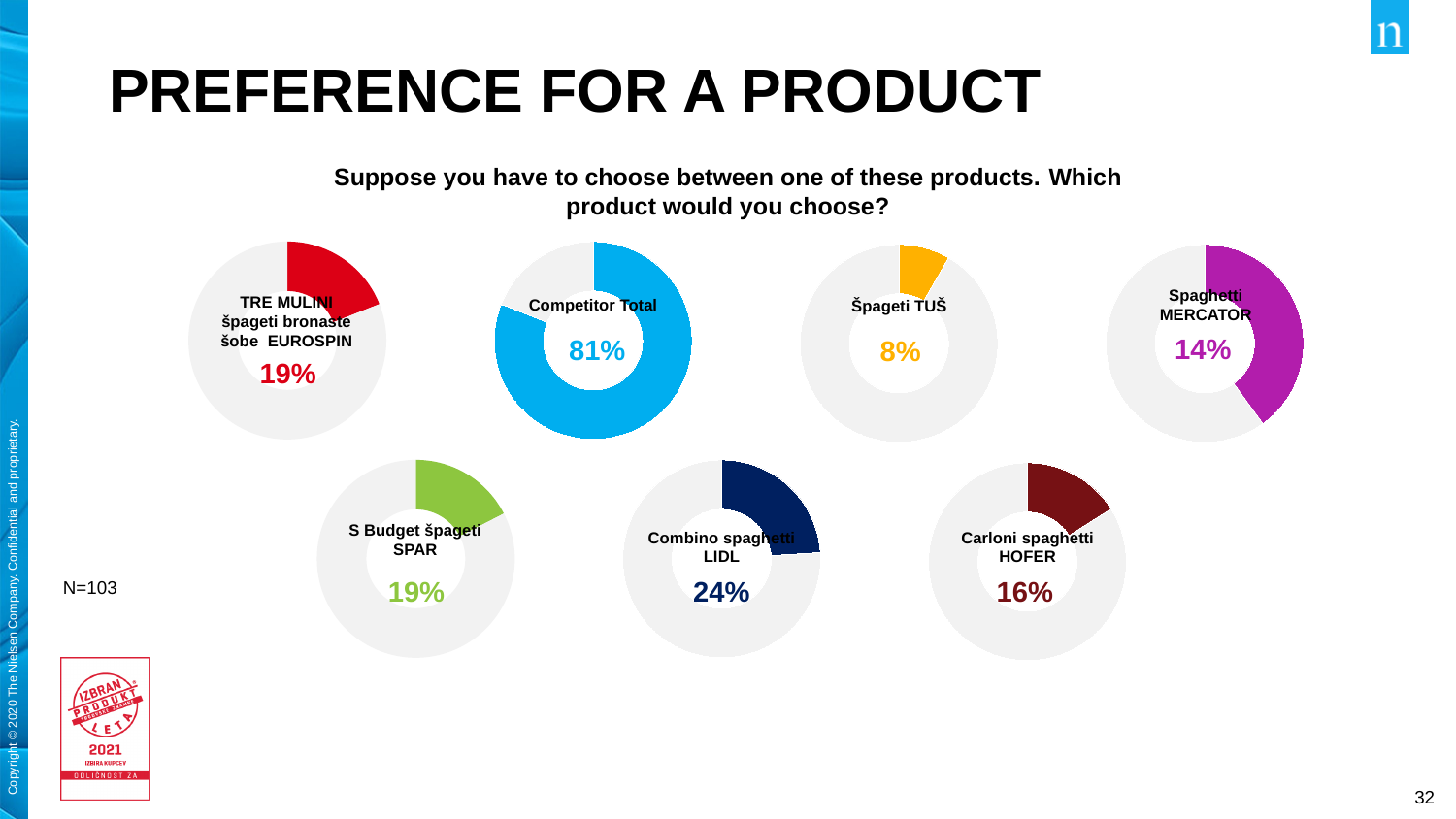
Which is larger, the percentage for Spaghetti MERCATOR or the percentage for TRE MULINI špageti bronaste šobe EUROSPIN? TRE MULINI špageti bronaste šobe EUROSPIN What is the difference between the Combino spaghetti LIDL percentage and the Carloni spaghetti HOFER percentage? 8% What percentage is shown in the Špageti TUŠ donut chart? 8% What percentage is shown in the Combino spaghetti LIDL donut chart? 24% What percentage is shown in the S Budget špageti SPAR donut chart? 19% How many donut charts are shown on the slide? 7 What percentage is shown in the Carloni spaghetti HOFER donut chart? 16% What percentage is shown in the Spaghetti MERCATOR donut chart? 14% Which product has the lowest preference percentage across all the donut charts? Špageti TUŠ What percentage is shown in the Competitor Total donut chart? 81% Among the individual competitor products (excluding Competitor Total), which product has the highest preference percentage? Combino spaghetti LIDL What colour is the filled segment of the Špageti TUŠ donut chart? Yellow/orange